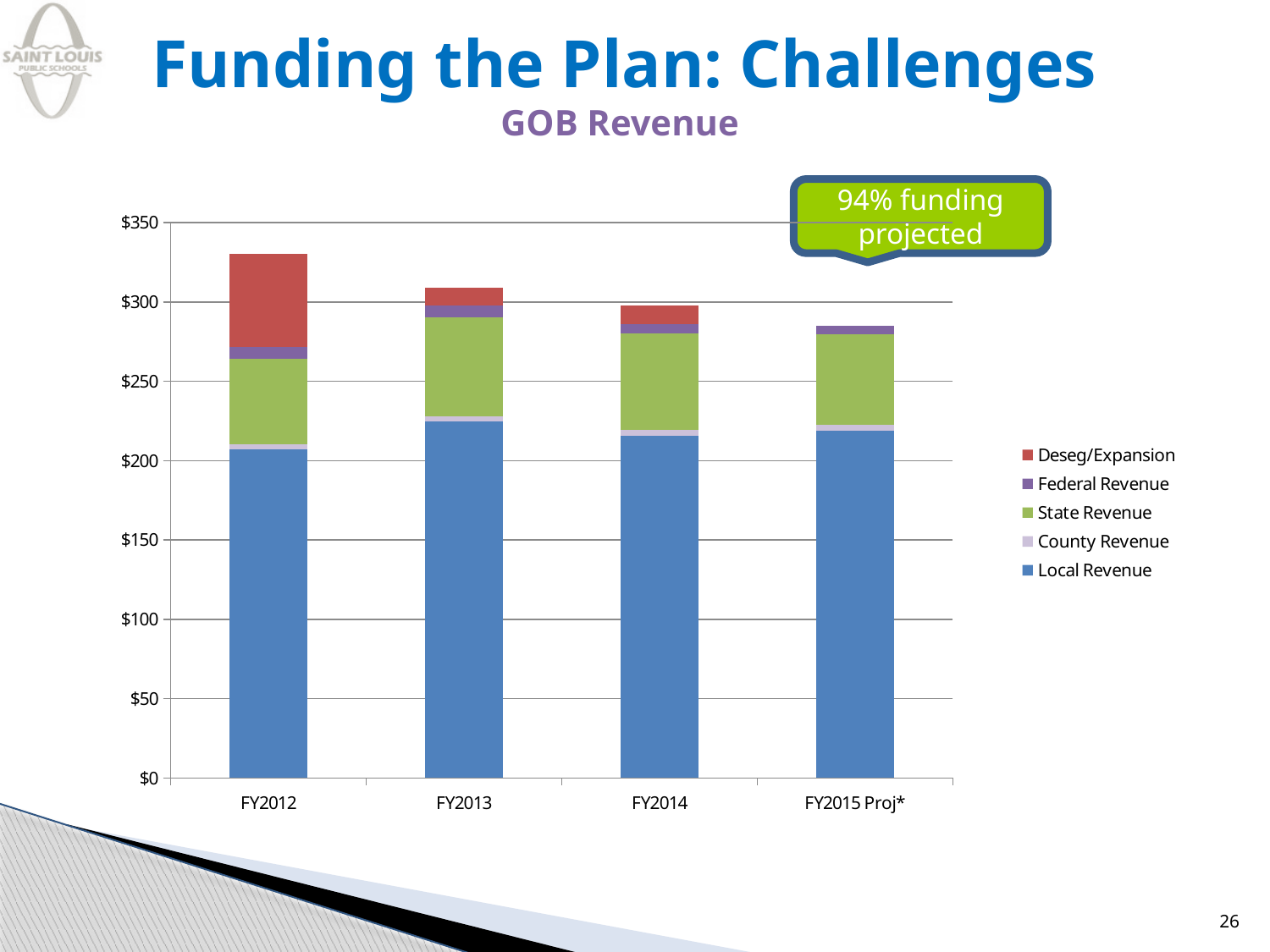
How many series does the legend list? 5 Which fiscal year has the shortest total bar? FY2015 Proj* What is the subtitle of the chart shown on the slide? GOB Revenue What kind of chart is shown on the slide? Stacked bar chart Is the total bar for FY2012 greater or less than $300? greater How many fiscal year categories are shown on the x axis? 4 Which series is shown in red in the legend? Deseg/Expansion Do the total bar heights rise or fall from FY2012 to FY2015 Proj*? Fall Is the total bar for FY2015 Proj* greater or less than $300? less Which is larger, the total bar for FY2012 or the total bar for FY2015 Proj*? FY2012 Which fiscal year has the tallest total bar? FY2012 Is the Local Revenue segment for FY2013 greater or less than $200? greater